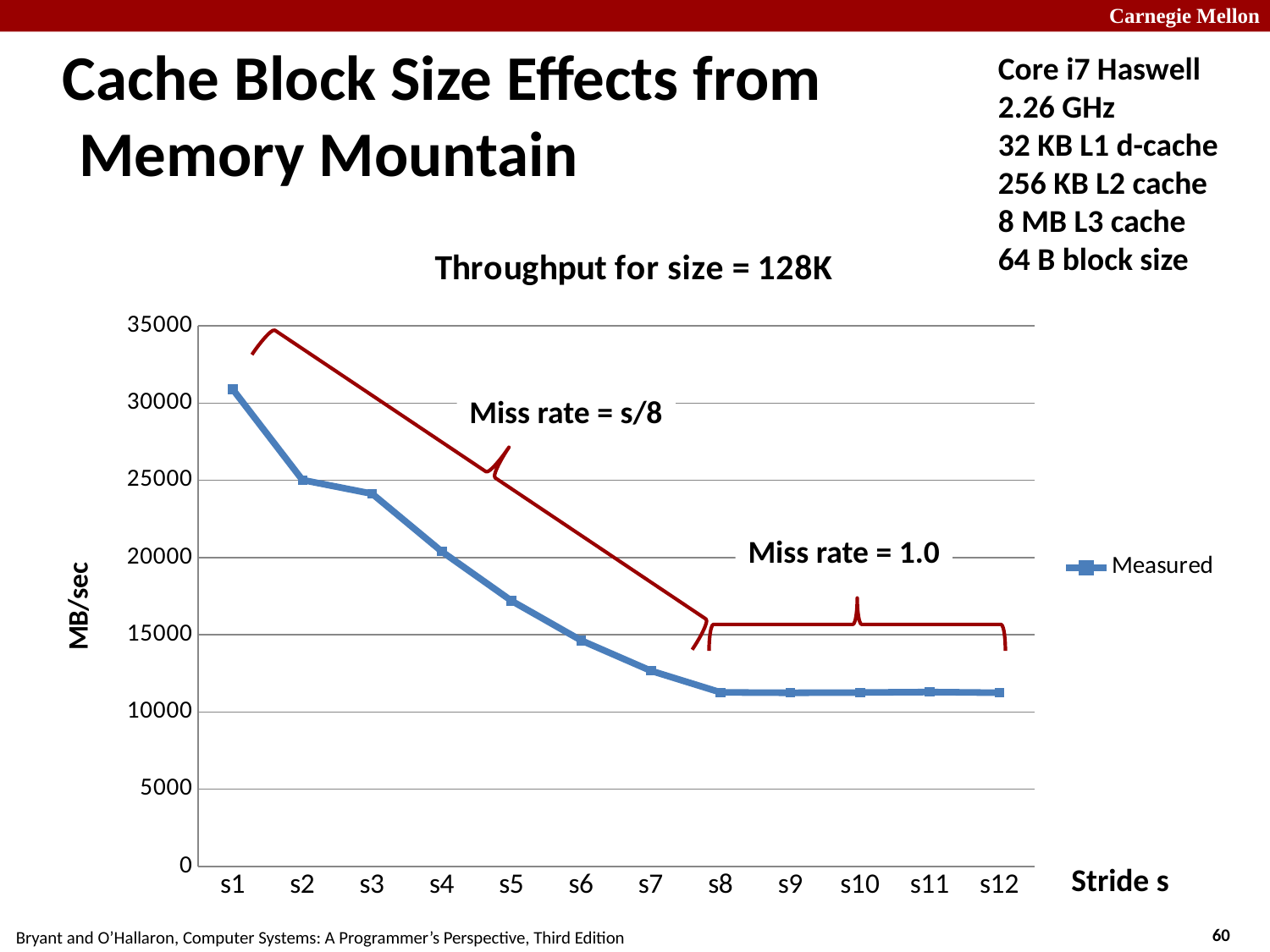
Which stride has the highest measured throughput? s1 What is the name of the series in the legend? Measured Is the measured value for s12 greater or less than 10000? greater Is the measured value for s7 greater or less than 15000? less How many series does the legend list? 1 Is the measured value for s1 greater or less than 30000? greater Which has the larger measured throughput, s2 or s7? s2 How many stride values are plotted along the x axis? 12 What is the title of the chart? Throughput for size = 128K Do the measured values rise or fall as the stride increases from s1 to s8? fall What kind of chart is shown on the slide? line chart